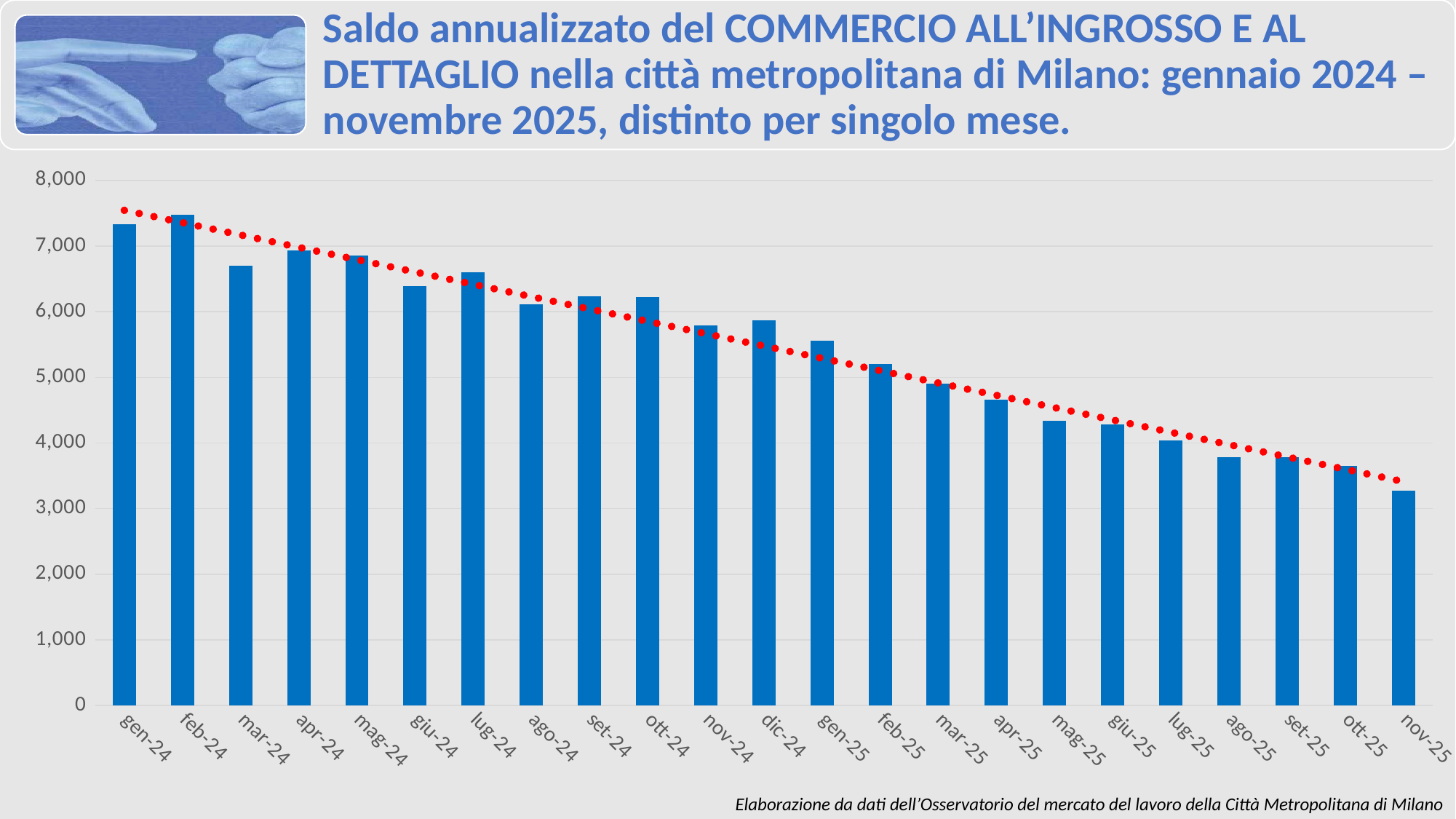
Is the value for apr-25 greater or less than 5,000? less Do the values generally rise or fall from gen-24 to nov-25? fall How many months (bars) are plotted in the chart? 23 Is the value for gen-24 greater or less than 7,000? greater What kind of chart is shown on the slide? bar chart Which is larger, the value for gen-25 or the value for mar-25? gen-25 Which month has the highest value in the chart? feb-24 Which is larger, the value for lug-25 or the value for nov-25? lug-25 Is the value for nov-25 greater or less than 3,000? greater What colour is the dotted trend line drawn over the bars? red Which month has the lowest value in the chart? nov-25